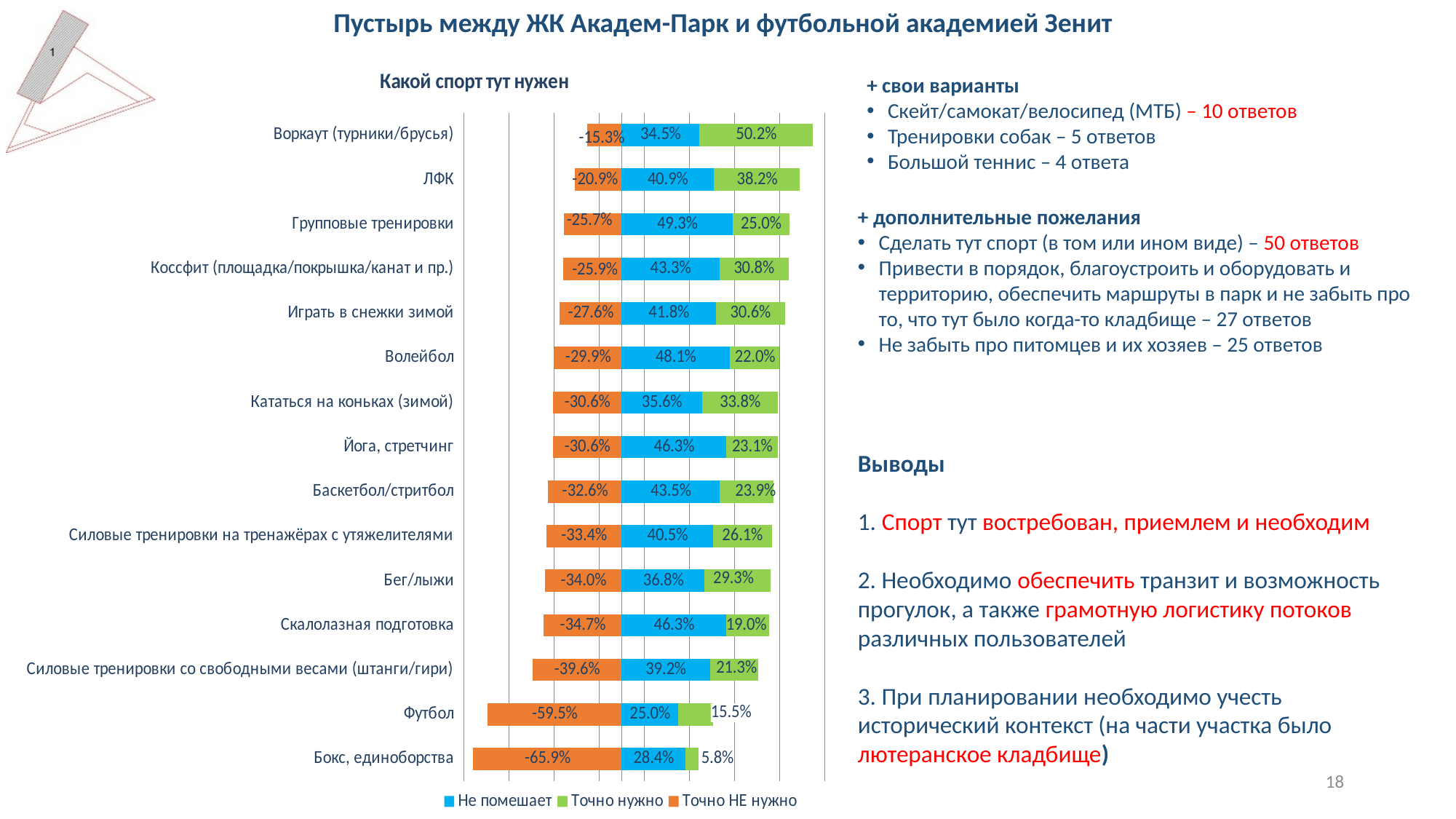
What is the 'Не помешает' value for Волейбол? 48.1% How many sport categories are shown in the chart? 15 Which category has the highest 'Точно нужно' value? Воркаут (турники/брусья) Which category has the lowest 'Точно нужно' value? Бокс, единоборства What is the 'Точно нужно' value for Воркаут (турники/брусья)? 50.2% Which category has the highest 'Не помешает' value? Групповые тренировки Which colour represents the 'Точно НЕ нужно' series? Orange What is the 'Точно НЕ нужно' value for Футбол? -59.5% What type of chart is used to show 'Какой спорт тут нужен'? Stacked bar chart Which is larger: the 'Точно нужно' value for Кататься на коньках (зимой) or for Йога, стретчинг? Кататься на коньках (зимой) How many series does the legend list? 3 What is the difference between the 'Точно нужно' values for Воркаут (турники/брусья) and ЛФК? 12.0%